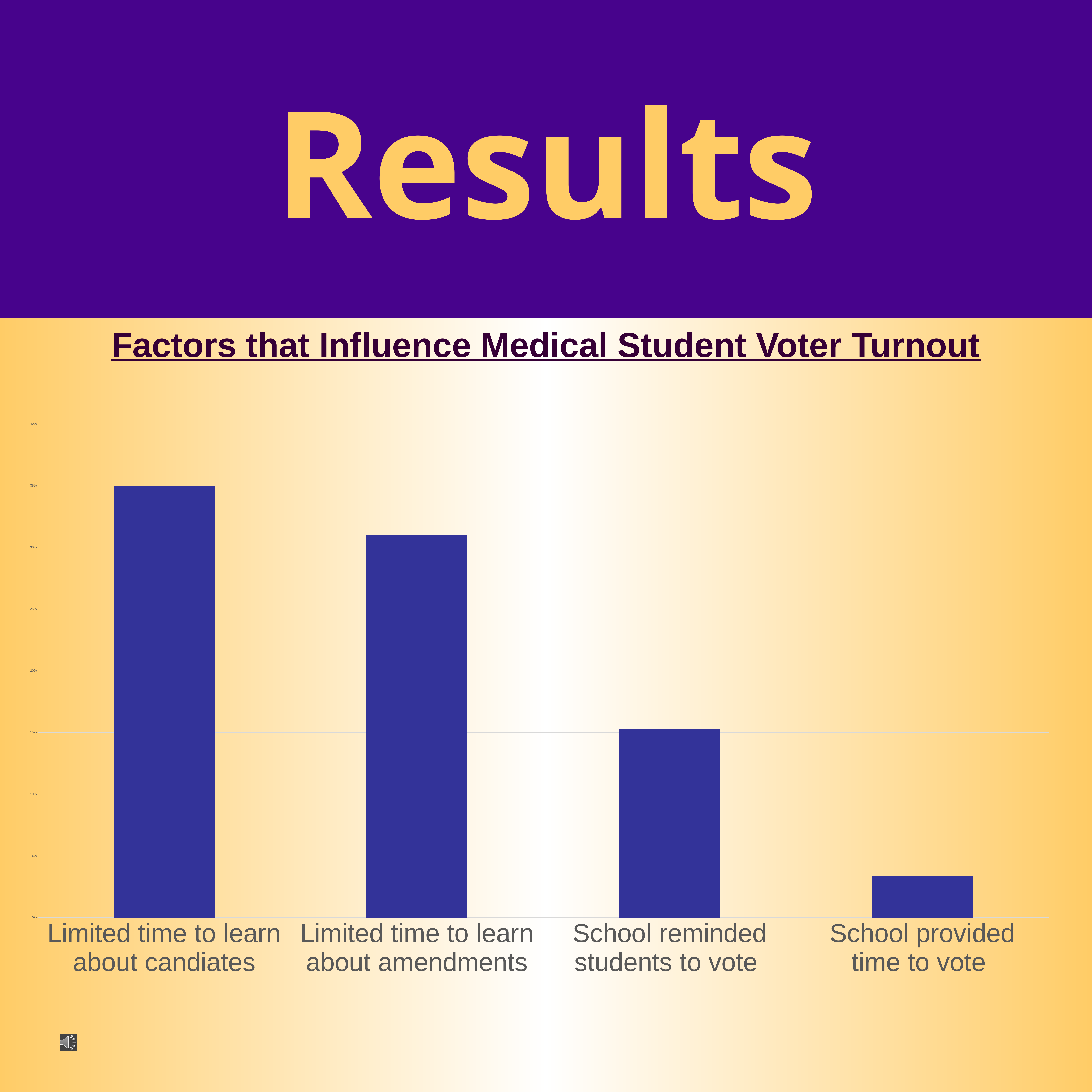
Which category has the lowest value? School provided time to vote Which is larger: the value for 'Limited time to learn about candiates' or 'Limited time to learn about amendments'? Limited time to learn about candiates Is the value for 'Limited time to learn about candiates' greater or less than 30%? greater Which category has the highest value? Limited time to learn about candiates Is the value for 'School reminded students to vote' greater or less than 20%? less What kind of chart is shown on the slide? bar chart Is the value for 'Limited time to learn about amendments' greater or less than 35%? less Do the values rise or fall moving from left to right across the categories? fall Which is larger: the value for 'School reminded students to vote' or 'School provided time to vote'? School reminded students to vote How many categories are shown in the chart? 4 What is the title of the chart? Factors that Influence Medical Student Voter Turnout